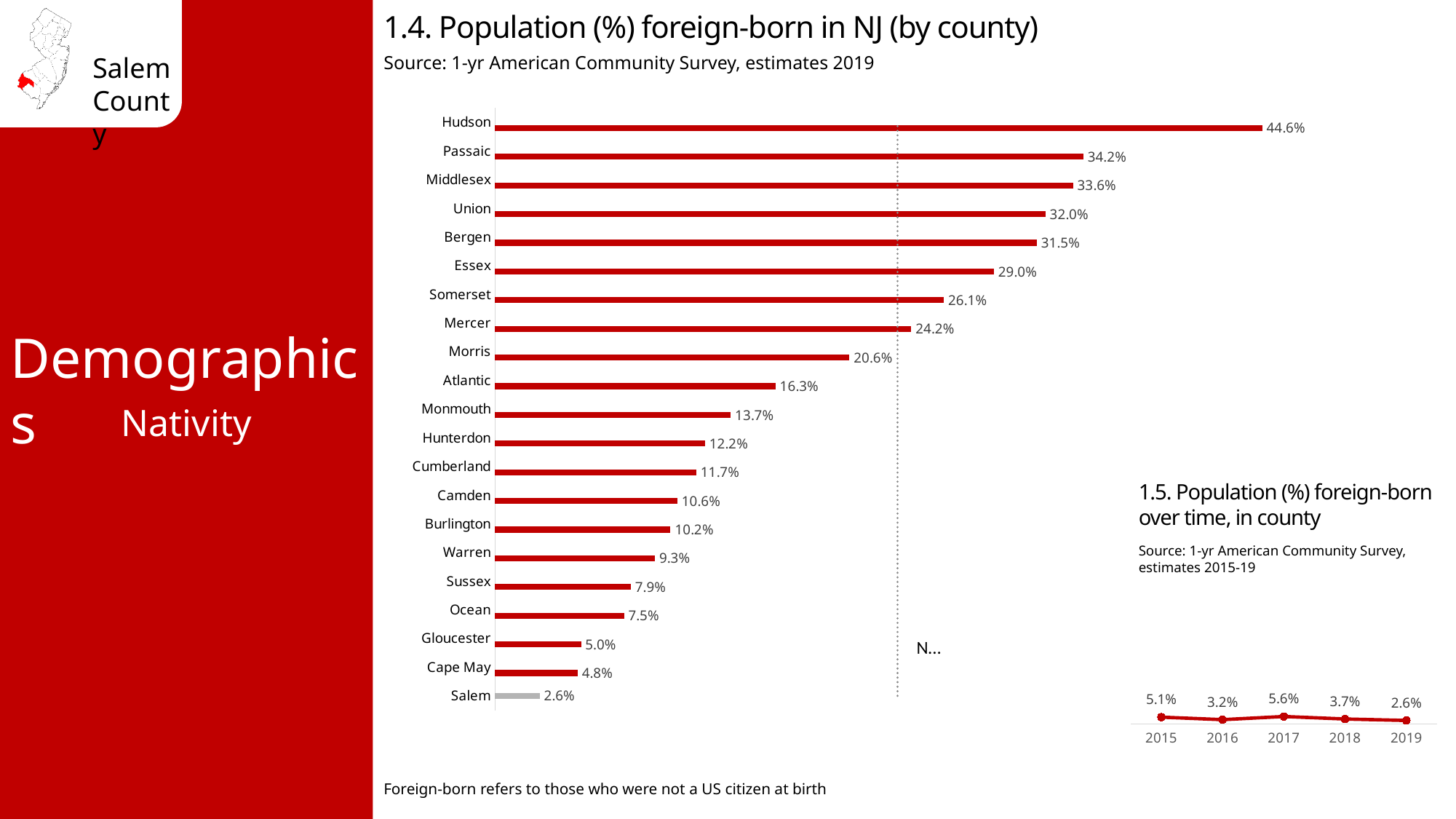
In the chart '1.4. Population (%) foreign-born in NJ (by county)', which county has the lowest value? Salem What kind of chart is '1.4. Population (%) foreign-born in NJ (by county)'? Bar chart In the chart '1.4. Population (%) foreign-born in NJ (by county)', which county has the highest value? Hudson In the chart '1.4. Population (%) foreign-born in NJ (by county)', which is larger, Camden or Burlington? Camden In the chart '1.5. Population (%) foreign-born over time, in county', what is the value for 2017? 5.6% In the chart '1.4. Population (%) foreign-born in NJ (by county)', what is the value for Salem? 2.6% In the chart '1.5. Population (%) foreign-born over time, in county', what is the difference between 2015 and 2019? 2.5% In the chart '1.5. Population (%) foreign-born over time, in county', which year has the lowest value? 2019 In the chart '1.4. Population (%) foreign-born in NJ (by county)', what is the value for Hudson? 44.6% What kind of chart is '1.5. Population (%) foreign-born over time, in county'? Line chart How many counties are shown in the chart '1.4. Population (%) foreign-born in NJ (by county)'? 21 In the chart '1.4. Population (%) foreign-born in NJ (by county)', what is the difference between Passaic and Middlesex? 0.6%